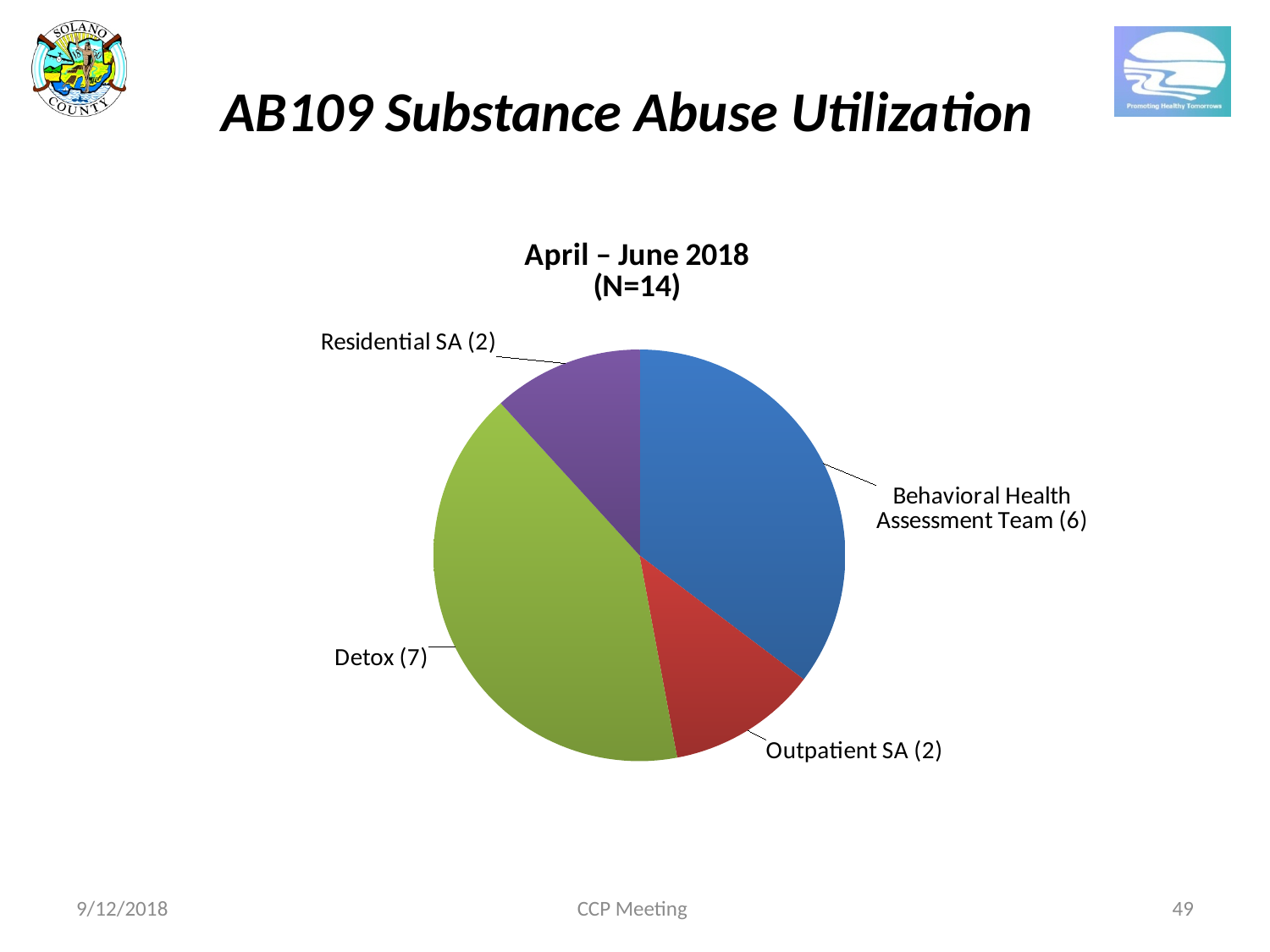
What is the value shown for Behavioral Health Assessment Team? 6 What is the value shown for Residential SA? 2 What is the value shown for Outpatient SA? 2 What is the value shown for Detox? 7 What is the difference between the values for Detox and Behavioral Health Assessment Team? 1 How many slices does the pie chart have? 4 Which is larger, the value for Detox or the value for Residential SA? Detox What kind of chart is shown on the slide? pie chart Which category has the largest slice of the pie? Detox What colour is the Detox slice? green What is the difference between the values for Behavioral Health Assessment Team and Outpatient SA? 4 What is the title of the pie chart? April – June 2018 (N=14)